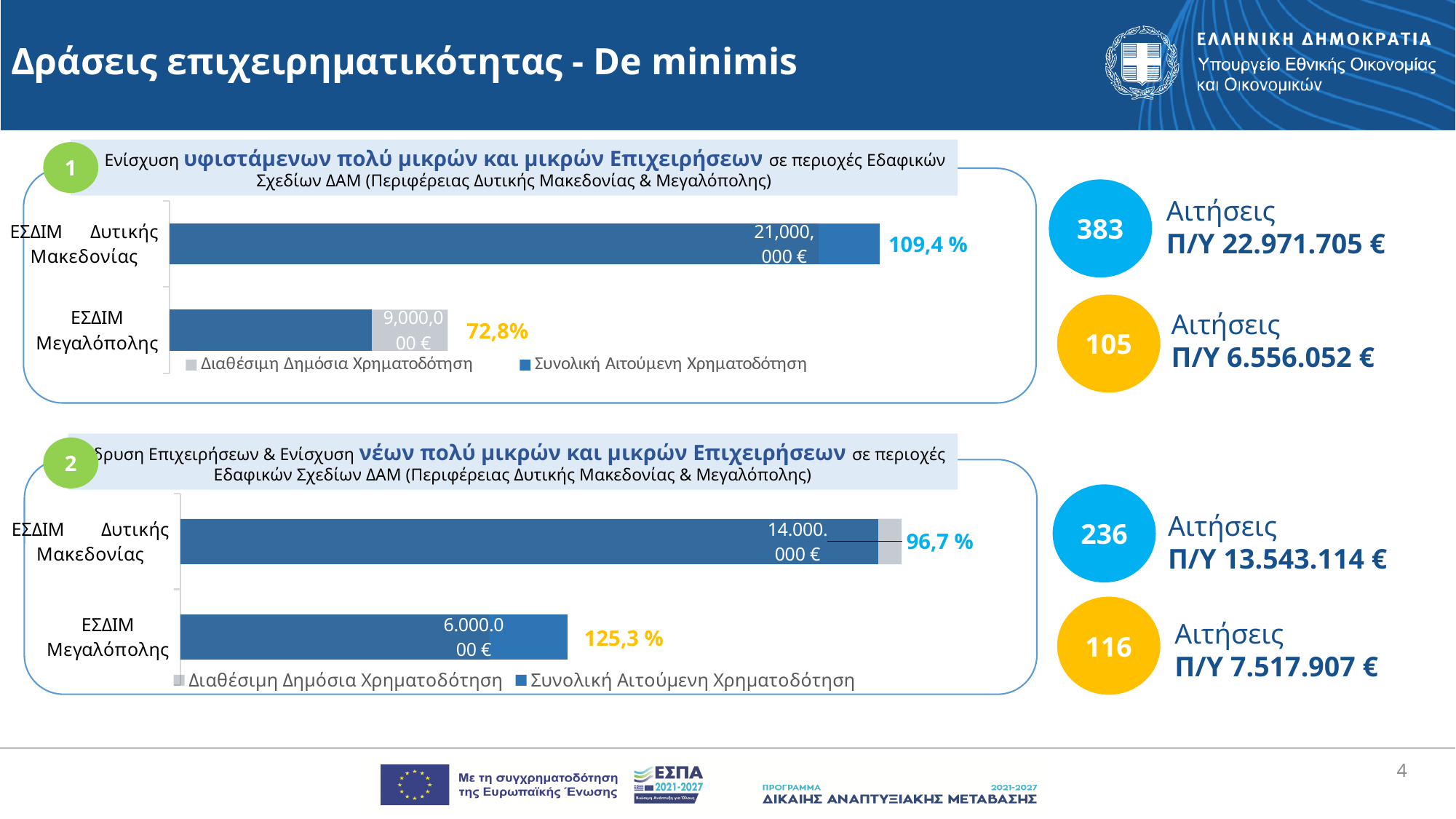
In the bottom chart, what percentage is shown next to the ΕΣΔΙΜ Μεγαλόπολης bar? 125,3 % In the top chart, what percentage is shown next to the ΕΣΔΙΜ Μεγαλόπολης bar? 72,8% In the top chart, what is the available public funding for ΕΣΔΙΜ Μεγαλόπολης? 9,000,000 € What kind of chart is the top chart? Bar chart In the top chart, what percentage is shown next to the ΕΣΔΙΜ Δυτικής Μακεδονίας bar? 109,4 % In the bottom chart, what is the difference in available public funding between ΕΣΔΙΜ Δυτικής Μακεδονίας and ΕΣΔΙΜ Μεγαλόπολης? 8.000.000 € In the bottom chart, what is the available public funding for ΕΣΔΙΜ Μεγαλόπολης? 6.000.000 € How many categories are shown in the top chart? 2 How many series does the legend of the bottom chart list? 2 In the bottom chart (Ίδρυση Επιχειρήσεων & Ενίσχυση νέων πολύ μικρών και μικρών Επιχειρήσεων), what is the available public funding for ΕΣΔΙΜ Δυτικής Μακεδονίας? 14.000.000 € In the top chart (Ενίσχυση υφιστάμενων πολύ μικρών και μικρών Επιχειρήσεων), what is the available public funding (Διαθέσιμη Δημόσια Χρηματοδότηση) for ΕΣΔΙΜ Δυτικής Μακεδονίας? 21,000,000 € In the top chart, which category has the larger available public funding? ΕΣΔΙΜ Δυτικής Μακεδονίας